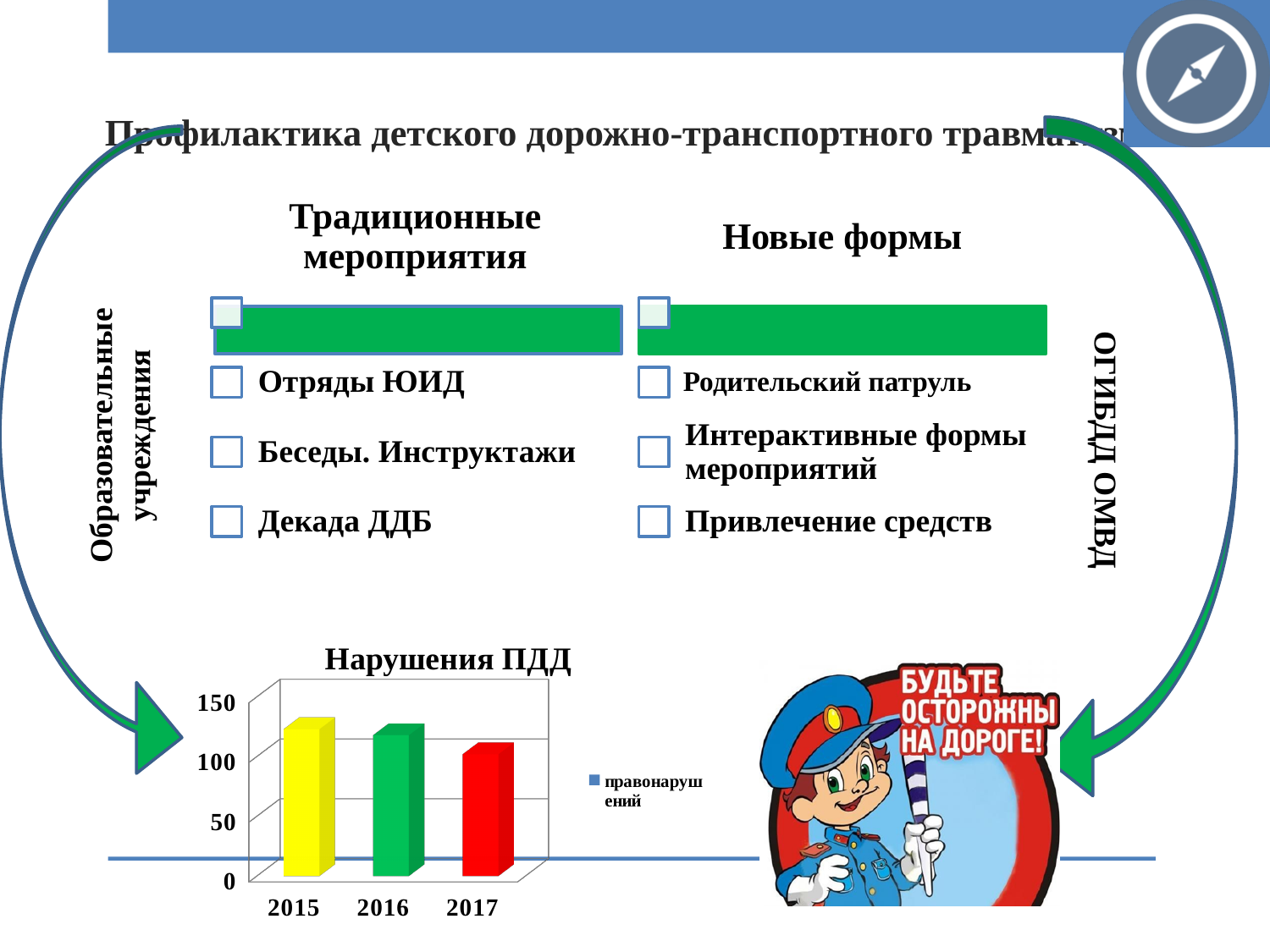
How many series does the legend of the 'Нарушения ПДД' chart list? 1 In the 'Нарушения ПДД' chart, which is larger, the value for 2016 or the value for 2017? 2016 In the 'Нарушения ПДД' chart, which is larger, the value for 2015 or the value for 2017? 2015 What is the series name shown in the legend of the 'Нарушения ПДД' chart? правонарушений How many categories (years) are shown on the x axis of the 'Нарушения ПДД' chart? 3 In the 'Нарушения ПДД' chart, is the value for 2015 greater or less than 150? less Which year has the lowest bar in the 'Нарушения ПДД' chart? 2017 Do the values in the 'Нарушения ПДД' chart rise or fall from 2015 to 2017? fall What kind of chart is shown under the title 'Нарушения ПДД'? bar chart In the 'Нарушения ПДД' chart, is the value for 2016 greater or less than 100? greater What is the title of the chart on the slide? Нарушения ПДД